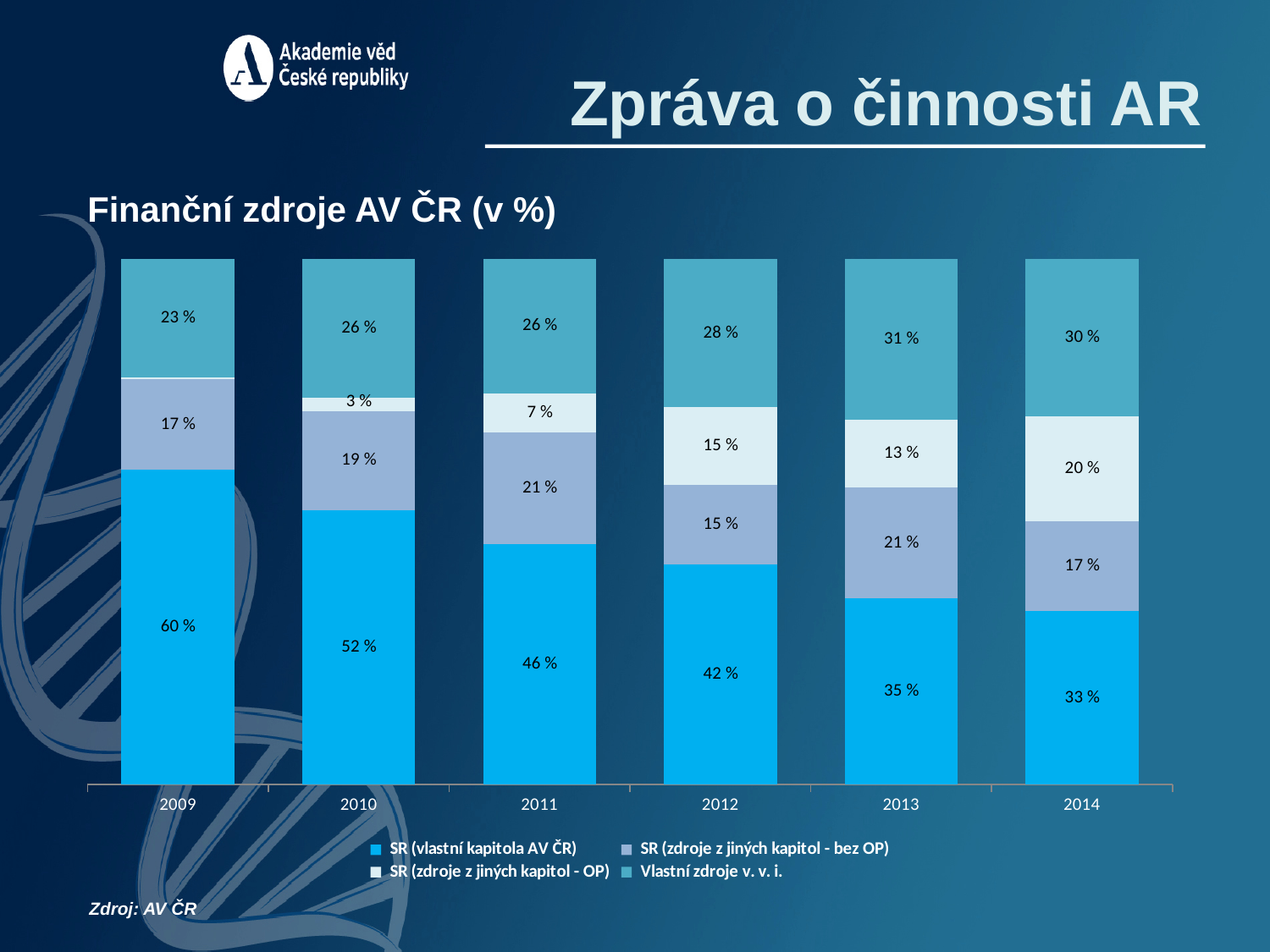
What is the value for SR (vlastní kapitola AV ČR) in 2009? 60 % What kind of chart is shown on the slide? Stacked bar chart How many years are shown on the x axis? 6 What is the value for Vlastní zdroje v. v. i. in 2013? 31 % How many series does the legend list? 4 What is the value for SR (zdroje z jiných kapitol - bez OP) in 2011? 21 % What is the difference between the SR (vlastní kapitola AV ČR) values for 2009 and 2014? 27 % Which is larger, the Vlastní zdroje v. v. i. value in 2012 or in 2009? 2012 In which year is the share of SR (vlastní kapitola AV ČR) the lowest? 2014 In which year is the share of SR (zdroje z jiných kapitol - OP) the highest? 2014 Does the share of SR (vlastní kapitola AV ČR) rise or fall from 2009 to 2014? Fall What is the value for SR (zdroje z jiných kapitol - OP) in 2014? 20 %